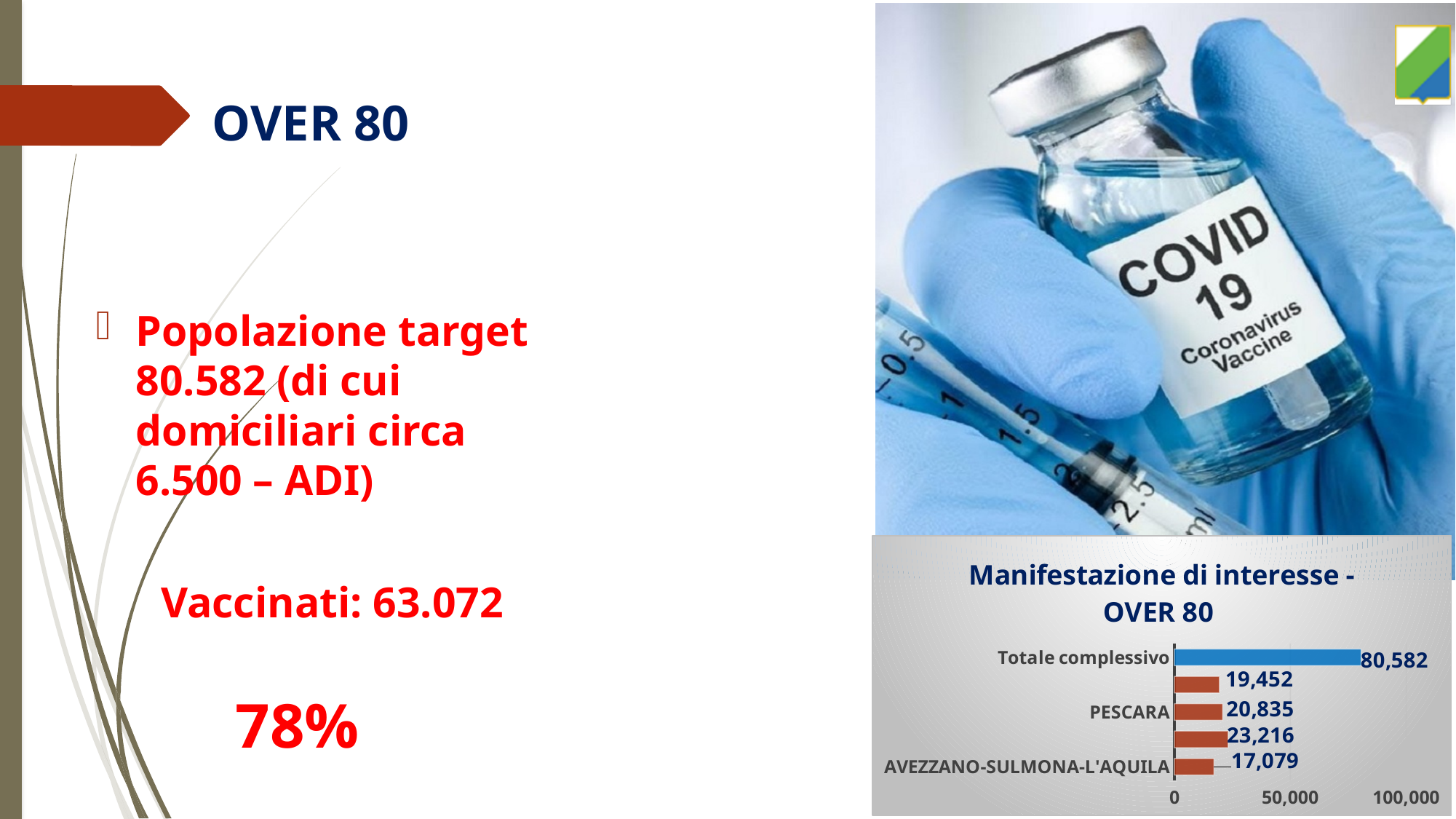
How many bars are plotted in the Manifestazione di interesse - OVER 80 chart? 5 In the Manifestazione di interesse - OVER 80 chart, is the value for Totale complessivo greater or less than 50,000? greater Which category has the lowest value in the Manifestazione di interesse - OVER 80 chart? AVEZZANO-SULMONA-L'AQUILA In the Manifestazione di interesse - OVER 80 chart, what is the difference between the values for PESCARA and AVEZZANO-SULMONA-L'AQUILA? 3,756 What is the value for Totale complessivo in the Manifestazione di interesse - OVER 80 chart? 80,582 In the Manifestazione di interesse - OVER 80 chart, which is larger: PESCARA or AVEZZANO-SULMONA-L'AQUILA? PESCARA In the Manifestazione di interesse - OVER 80 chart, what is the difference between Totale complessivo and PESCARA? 59,747 What kind of chart is the Manifestazione di interesse - OVER 80 chart? Bar chart What is the value for PESCARA in the Manifestazione di interesse - OVER 80 chart? 20,835 Which category has the highest value in the Manifestazione di interesse - OVER 80 chart? Totale complessivo What is the value for AVEZZANO-SULMONA-L'AQUILA in the Manifestazione di interesse - OVER 80 chart? 17,079 In the Manifestazione di interesse - OVER 80 chart, is the value for PESCARA greater or less than 50,000? less